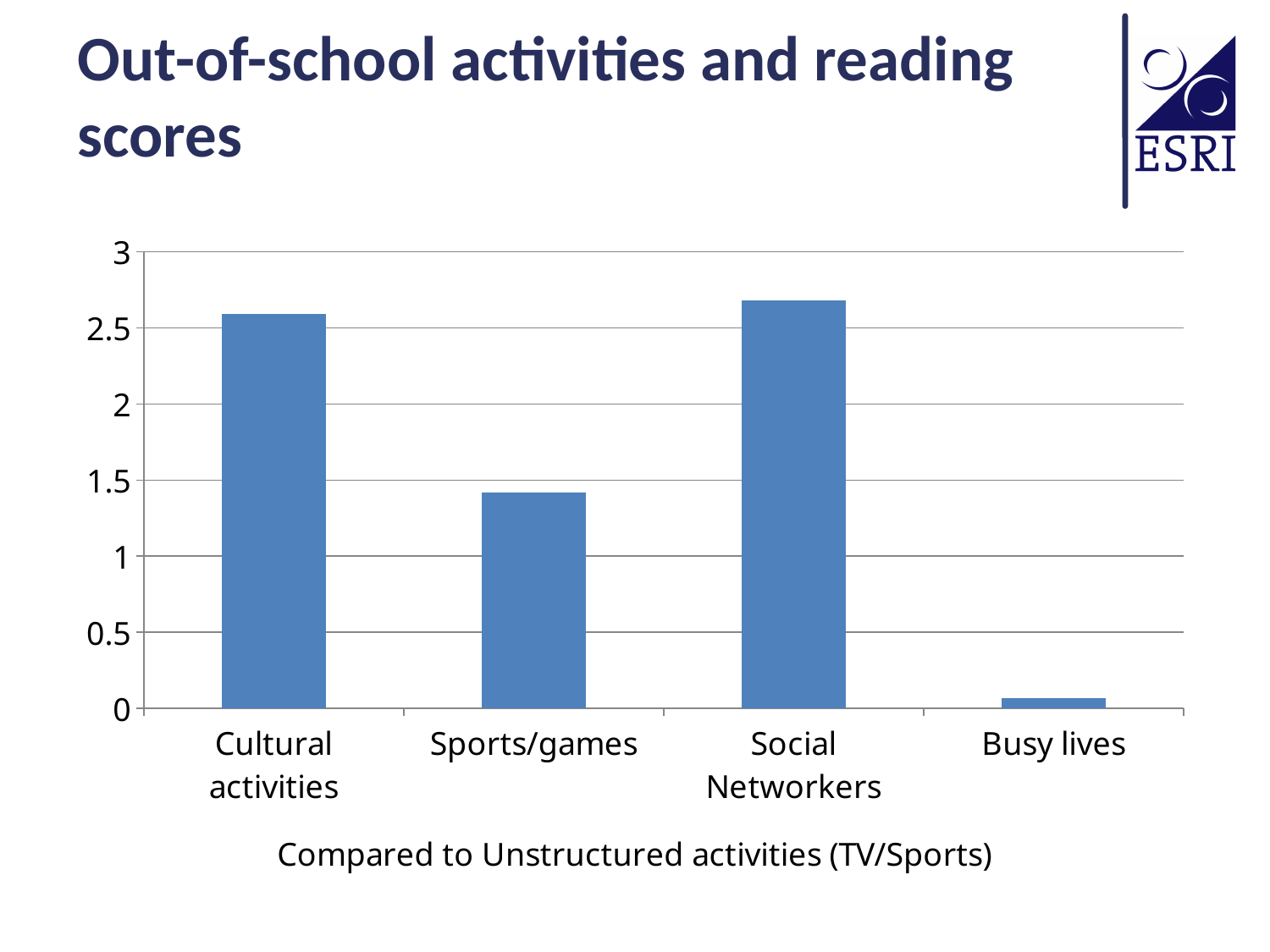
Which is larger, the value for Busy lives or the value for Sports/games? Sports/games What is the highest value shown on the y axis of the chart? 3 Is the value for Sports/games greater or less than 1? greater How many categories are shown on the x axis of the chart? 4 Which category has the lowest value in the chart? Busy lives Is the value for Sports/games greater or less than 1.5? less What is the label shown beneath the x axis of the chart? Compared to Unstructured activities (TV/Sports) Is the value for Social Networkers greater or less than 2.5? greater What kind of chart is shown on the slide? Bar chart Which is larger, the value for Cultural activities or the value for Sports/games? Cultural activities